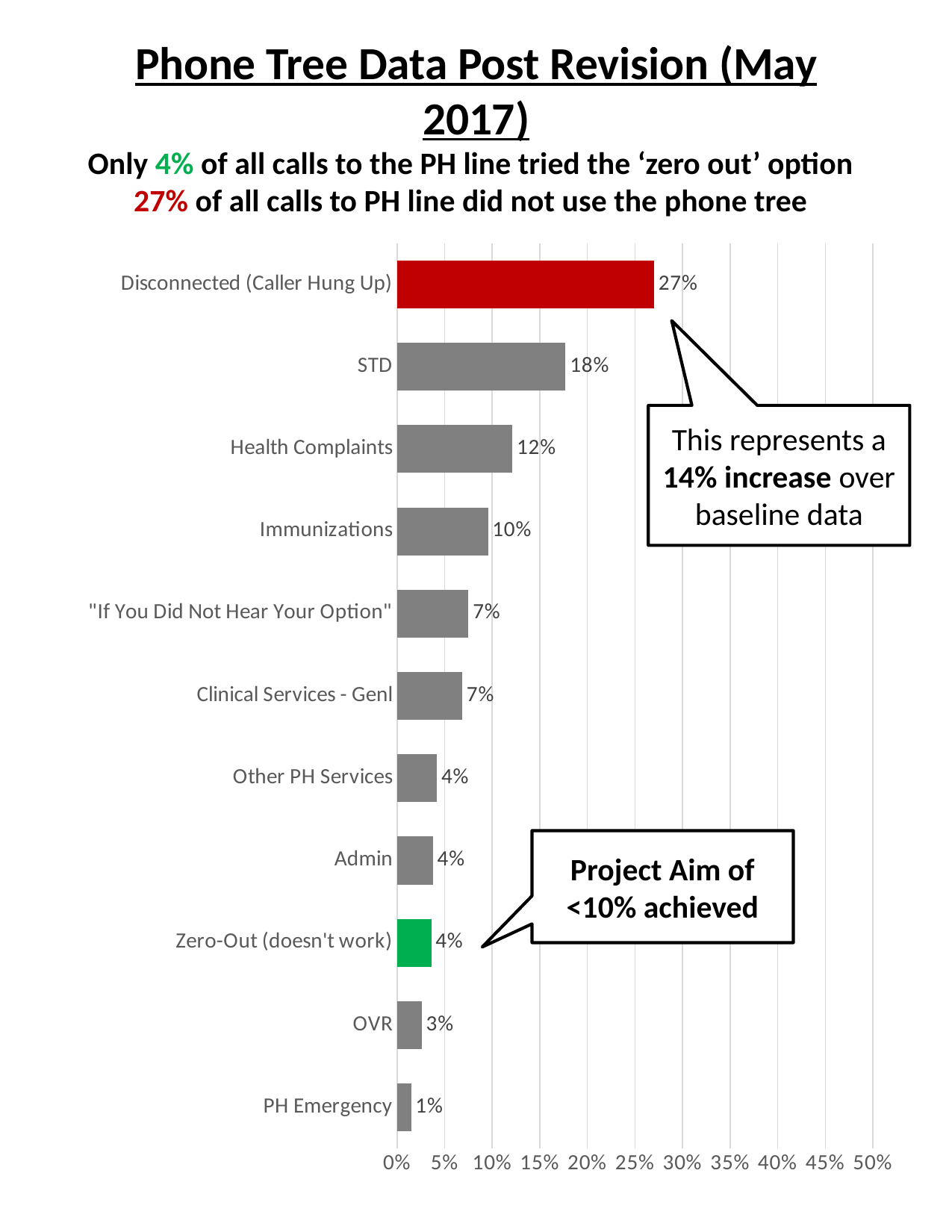
What is the value for STD? 18% What is the value for Zero-Out (doesn't work)? 4% What is the value for Immunizations? 10% Which is larger, the value for Health Complaints or the value for Immunizations? Health Complaints Which category has the highest value? Disconnected (Caller Hung Up) What kind of chart is shown on the slide? Bar chart Which bar is coloured green? Zero-Out (doesn't work) How many categories are shown in the chart? 11 What is the value for Disconnected (Caller Hung Up)? 27% What is the difference between the values for Disconnected (Caller Hung Up) and STD? 9% Which category has the lowest value? PH Emergency What is the difference between the values for OVR and PH Emergency? 2%